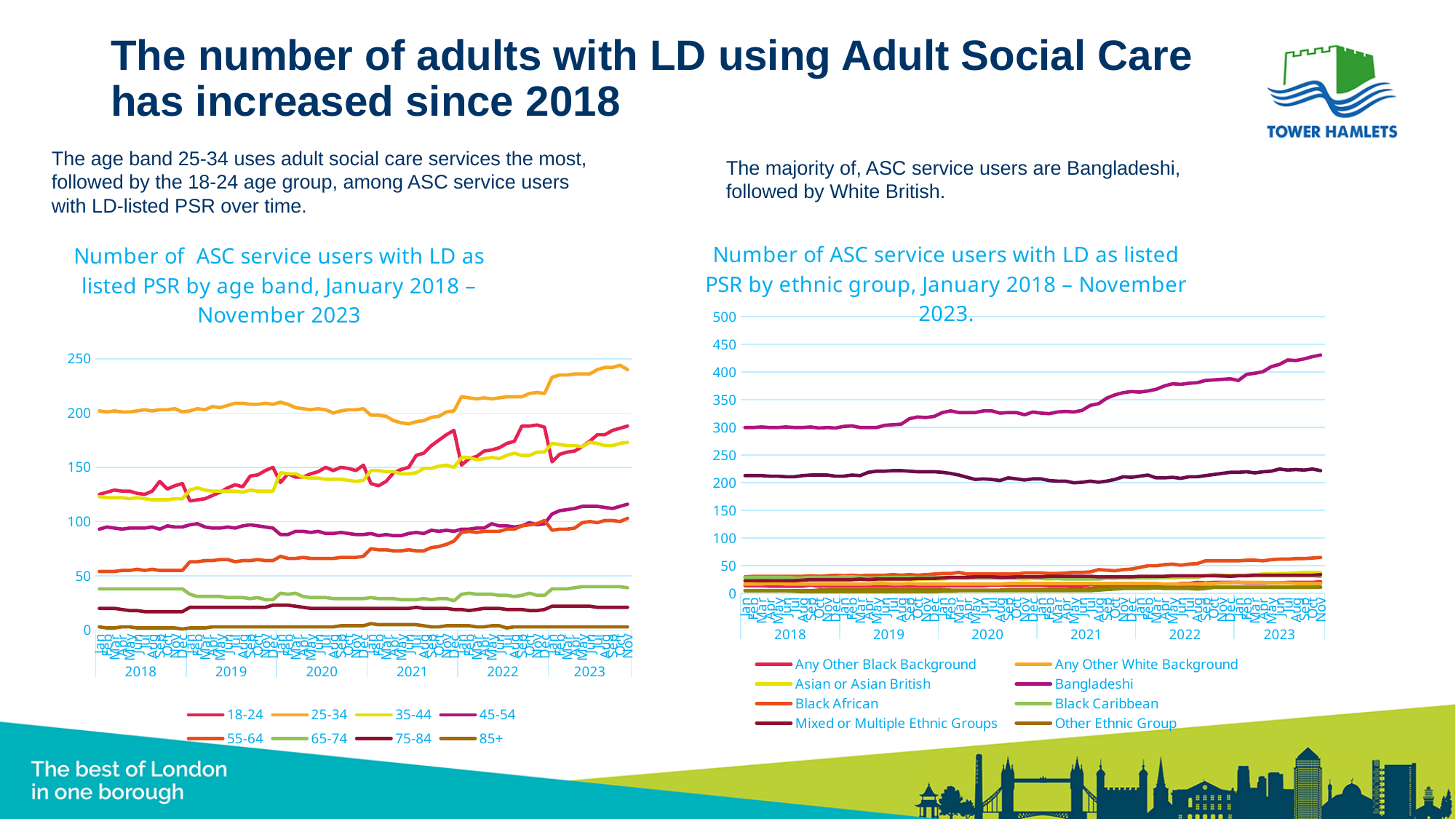
How many series does the legend of the left chart (by age band) list? 8 What is the title of the right chart? Number of ASC service users with LD as listed PSR by ethnic group, January 2018 – November 2023. In the right chart (by ethnic group), is the value for Bangladeshi in November 2023 greater or less than 400? greater What type of chart is the left chart, 'Number of ASC service users with LD as listed PSR by age band'? line chart How many series does the legend of the right chart (by ethnic group) list? 8 In the right chart (by ethnic group), which series is larger in 2023: Bangladeshi or Mixed or Multiple Ethnic Groups? Bangladeshi In the left chart (by age band), which age band has the highest number of ASC service users throughout the period? 25-34 In the left chart (by age band), is the value for the 25-34 age band in late 2023 greater or less than 200? greater In the left chart (by age band), which age band has the lowest number of ASC service users throughout the period? 85+ In the right chart (by ethnic group), which ethnic group has the highest number of ASC service users throughout the period? Bangladeshi In the right chart (by ethnic group), does the Bangladeshi line rise or fall from January 2018 to November 2023? rise In the right chart (by ethnic group), is the value for Black African in 2023 greater or less than 100? less